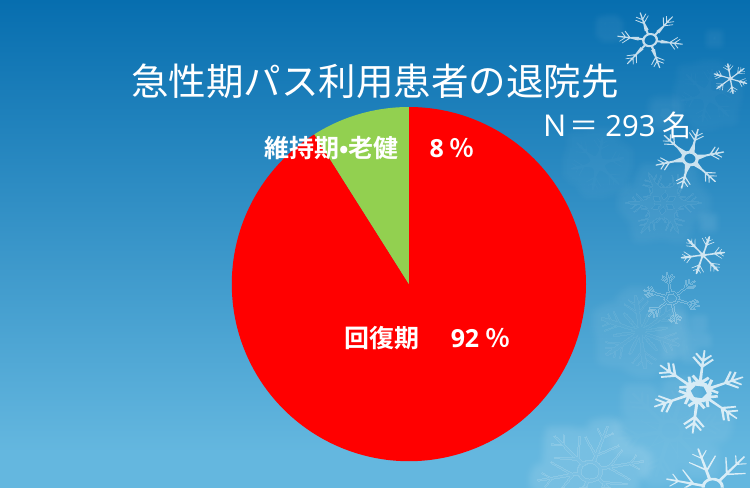
What is the title of the chart? 急性期パス利用患者の退院先 What kind of chart is shown on the slide? pie chart How many slices does the pie chart have? 2 What percentage of patients were discharged to 回復期? 92 % Which discharge destination has the smallest share of the pie? 維持期・老健 What percentage of patients were discharged to 維持期・老健? 8 % What share of the pie does the 回復期 slice represent? 92 % What is the total number of patients (N) shown on the slide? 293 名 Which discharge destination has the largest share of the pie? 回復期 Which is larger, the share for 回復期 or the share for 維持期・老健? 回復期 What is the difference in percentage points between 回復期 and 維持期・老健? 84